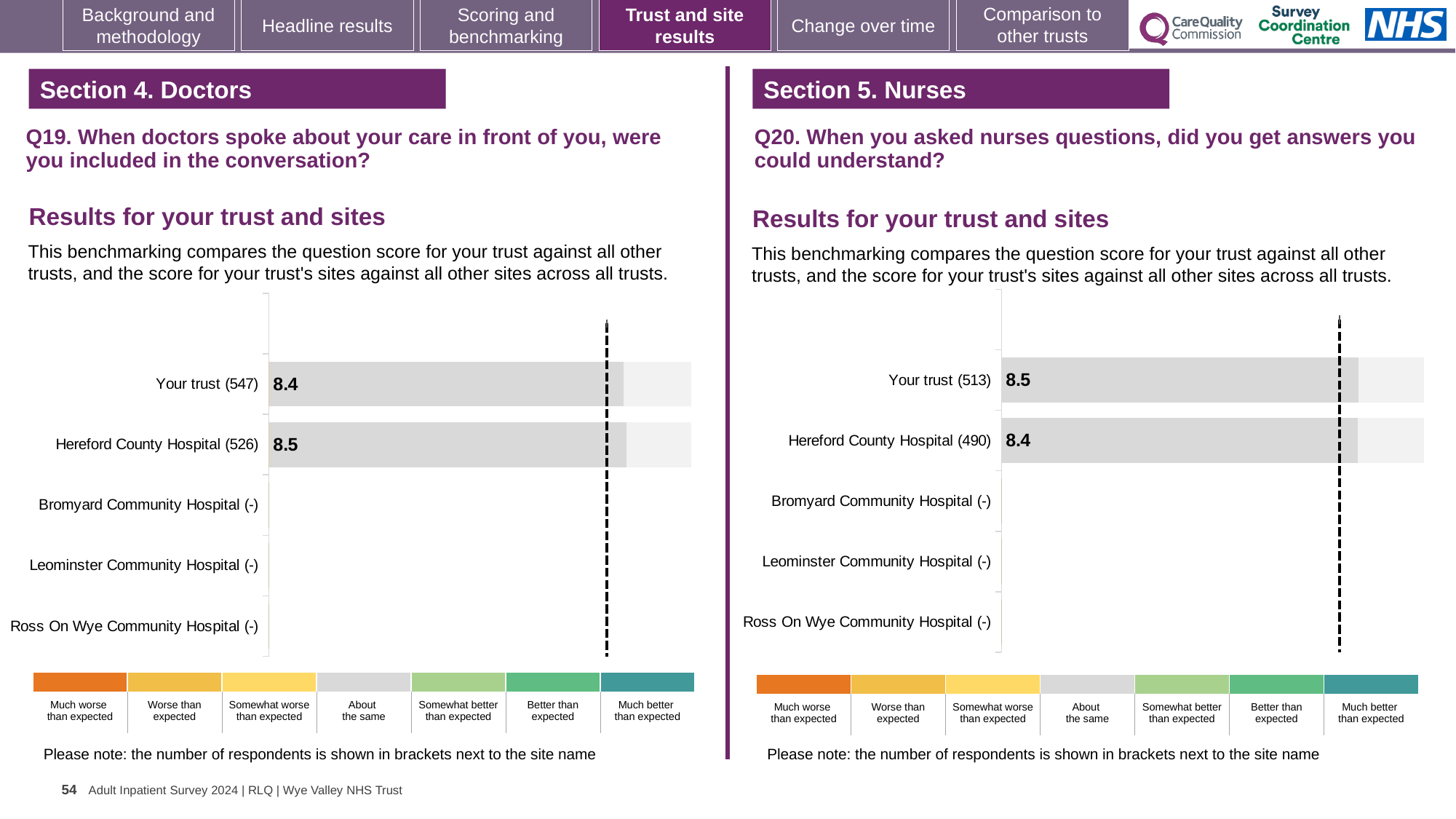
On the Q20 chart (Section 5. Nurses), which has the higher score, Your trust or Hereford County Hospital? Your trust On the Q20 chart (Section 5. Nurses), what is the score for Hereford County Hospital? 8.4 On the Q20 chart (Section 5. Nurses), what is the difference between the Your trust score and the Hereford County Hospital score? 0.1 On the Q19 chart (Section 4. Doctors), what is the difference between the Hereford County Hospital score and the Your trust score? 0.1 What kind of chart is used on the Q20 chart (Section 5. Nurses)? Bar chart On the Q19 chart (Section 4. Doctors), how many respondents are shown in brackets for Your trust? 547 On the Q20 chart (Section 5. Nurses), what is the score for Your trust? 8.5 On the Q19 chart (Section 4. Doctors), what is the score for Hereford County Hospital? 8.5 How many site/trust categories are listed on the Q19 chart (Section 4. Doctors)? 5 On the Q19 chart (Section 4. Doctors), what is the score for Your trust? 8.4 On the Q19 chart (Section 4. Doctors), which has the higher score, Your trust or Hereford County Hospital? Hereford County Hospital On the Q20 chart (Section 5. Nurses), how many respondents are shown in brackets for Hereford County Hospital? 490